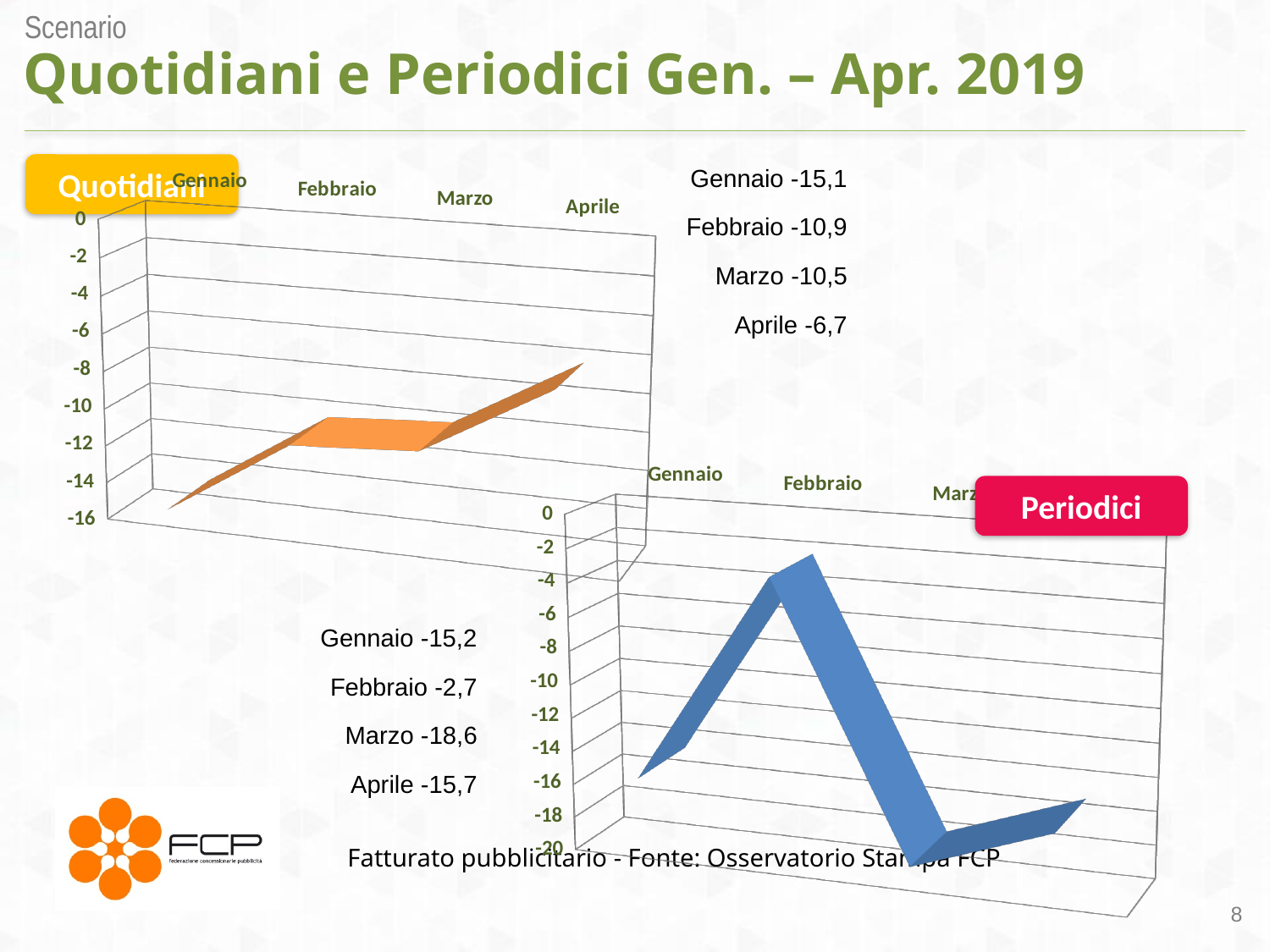
In the Quotidiani chart, what is the value for Gennaio? -15,1 What colour is the line in the Quotidiani chart? orange In the Periodici chart, what is the value for Marzo? -18,6 In the Quotidiani chart, what is the value for Aprile? -6,7 In the Quotidiani chart, which month has the highest value? Aprile What kind of chart is the Periodici chart? line chart In the Periodici chart, which month has the lowest value? Marzo In the Periodici chart, what is the value for Febbraio? -2,7 In the Periodici chart, which is larger, the value for Febbraio or the value for Aprile? Febbraio How many months are plotted in the Periodici chart? 4 In the Quotidiani chart, do the values rise or fall from Gennaio to Aprile? rise In the Quotidiani chart, what is the difference between the Gennaio value and the Aprile value? 8,4